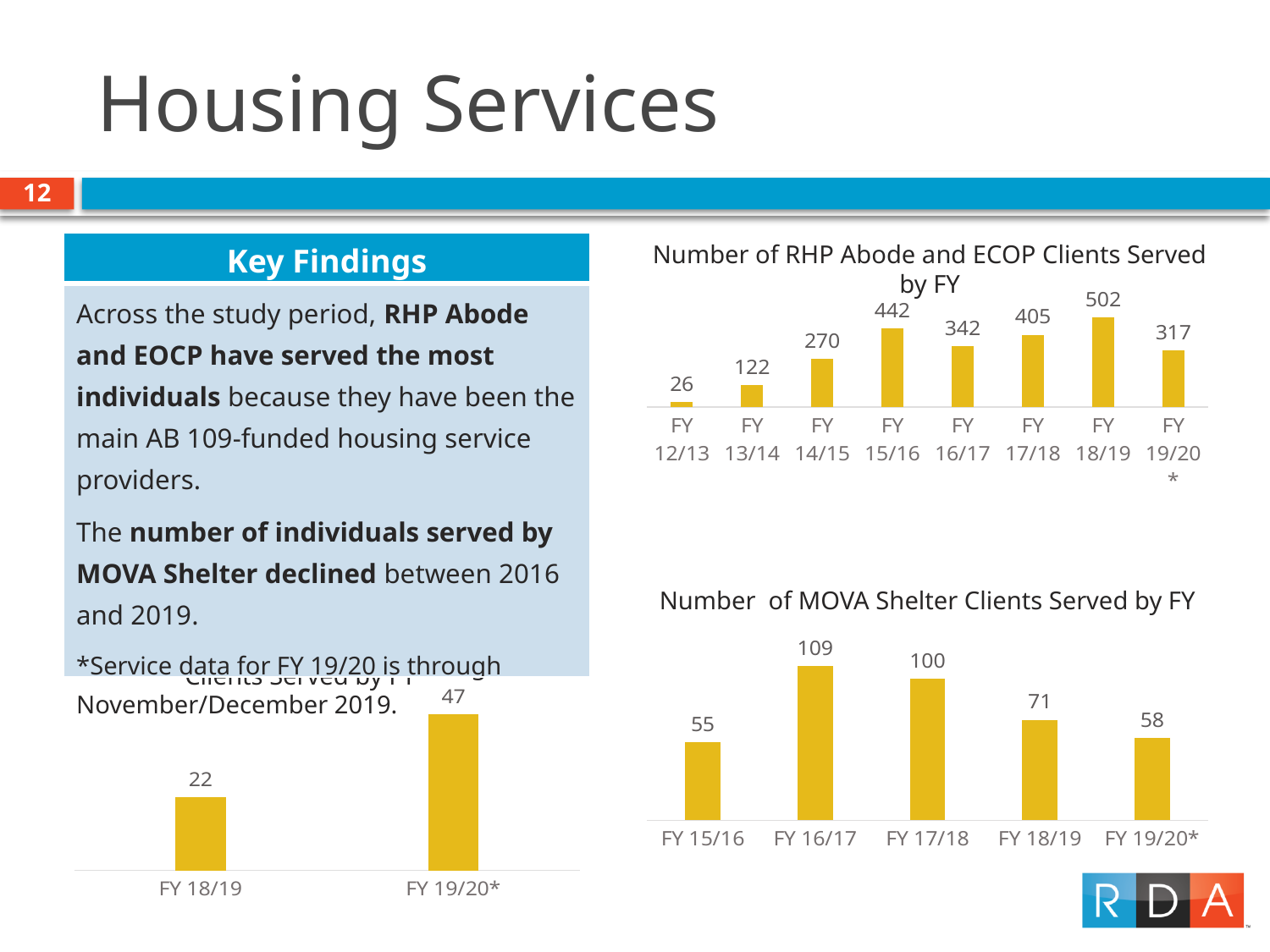
In the chart titled "Number of MOVA Shelter Clients Served by FY", which fiscal year has the highest value? FY 16/17 In the chart titled "Number of RHP Abode and ECOP Clients Served by FY", what is the value for FY 18/19? 502 What kind of chart is the bottom-left chart? bar chart In the chart titled "Number of MOVA Shelter Clients Served by FY", how many fiscal years are shown? 5 In the chart titled "Number of RHP Abode and ECOP Clients Served by FY", which fiscal year has the lowest value? FY 12/13 In the bottom-left chart, what is the value for FY 19/20*? 47 In the chart titled "Number of MOVA Shelter Clients Served by FY", what is the difference between the values for FY 16/17 and FY 19/20*? 51 In the chart titled "Number of RHP Abode and ECOP Clients Served by FY", which is larger, the value for FY 14/15 or the value for FY 19/20*? FY 19/20* In the chart titled "Number of MOVA Shelter Clients Served by FY", do the values rise or fall from FY 16/17 to FY 19/20*? fall In the chart titled "Number of MOVA Shelter Clients Served by FY", what is the value for FY 17/18? 100 In the chart titled "Number of RHP Abode and ECOP Clients Served by FY", what is the difference between the values for FY 15/16 and FY 16/17? 100 In the chart titled "Number of RHP Abode and ECOP Clients Served by FY", how many fiscal years are shown? 8